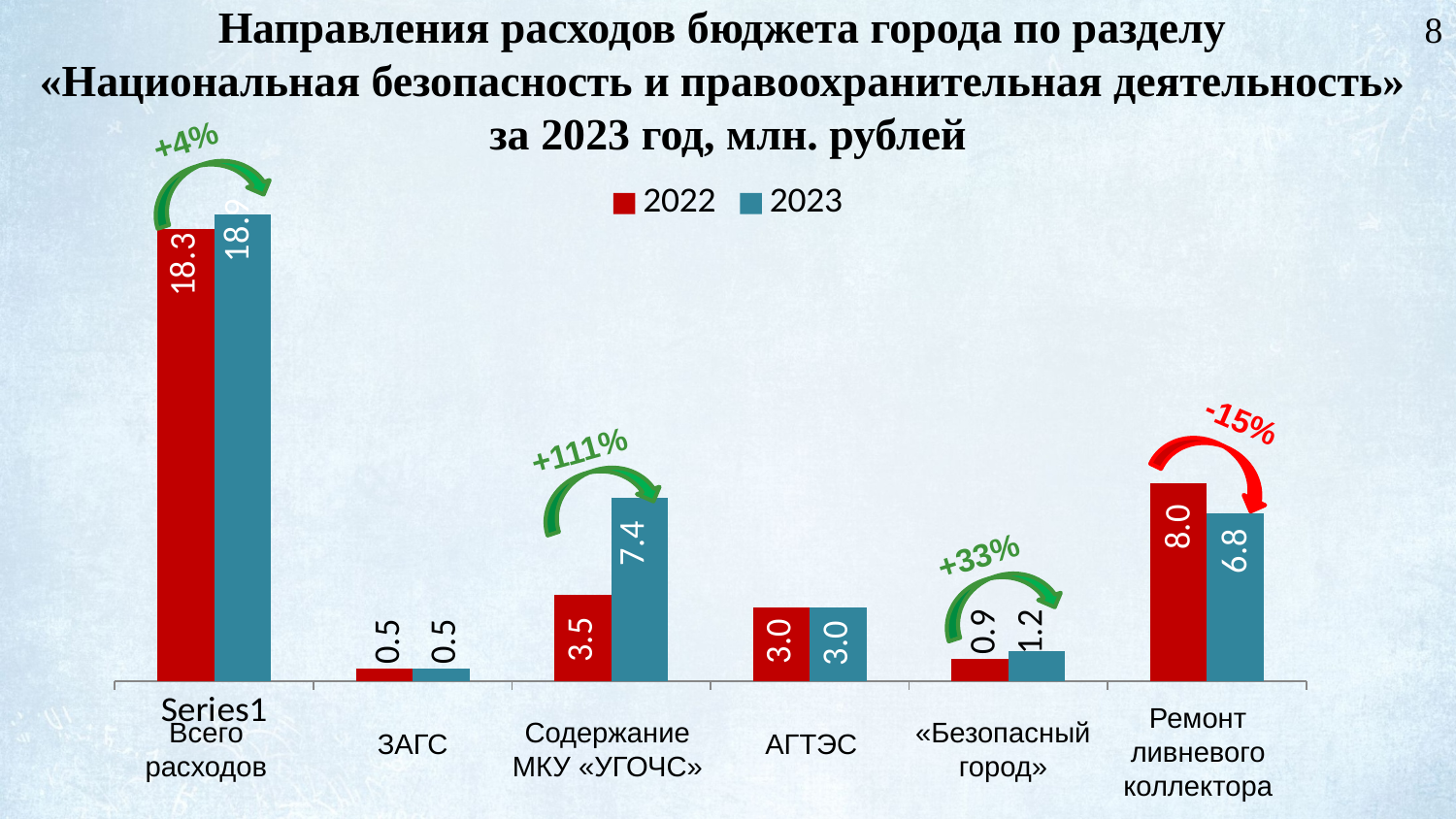
What is the 2022 value for Всего расходов? 18.3 What is the difference between the 2022 and 2023 values for Ремонт ливневого коллектора? 1.2 Which category has the lowest 2022 value? ЗАГС By how much did the value for Содержание МКУ «УГОЧС» increase from 2022 to 2023? 3.9 For Ремонт ливневого коллектора, which year has the larger value, 2022 or 2023? 2022 What percentage change is labelled above the bars for Содержание МКУ «УГОЧС»? +111% Which category has the highest 2023 value? Всего расходов What is the 2023 value for Ремонт ливневого коллектора? 6.8 What is the 2023 value for «Безопасный город»? 1.2 How many categories are shown on the x axis? 6 How many series does the legend list? 2 What is the 2022 value for Содержание МКУ «УГОЧС»? 3.5